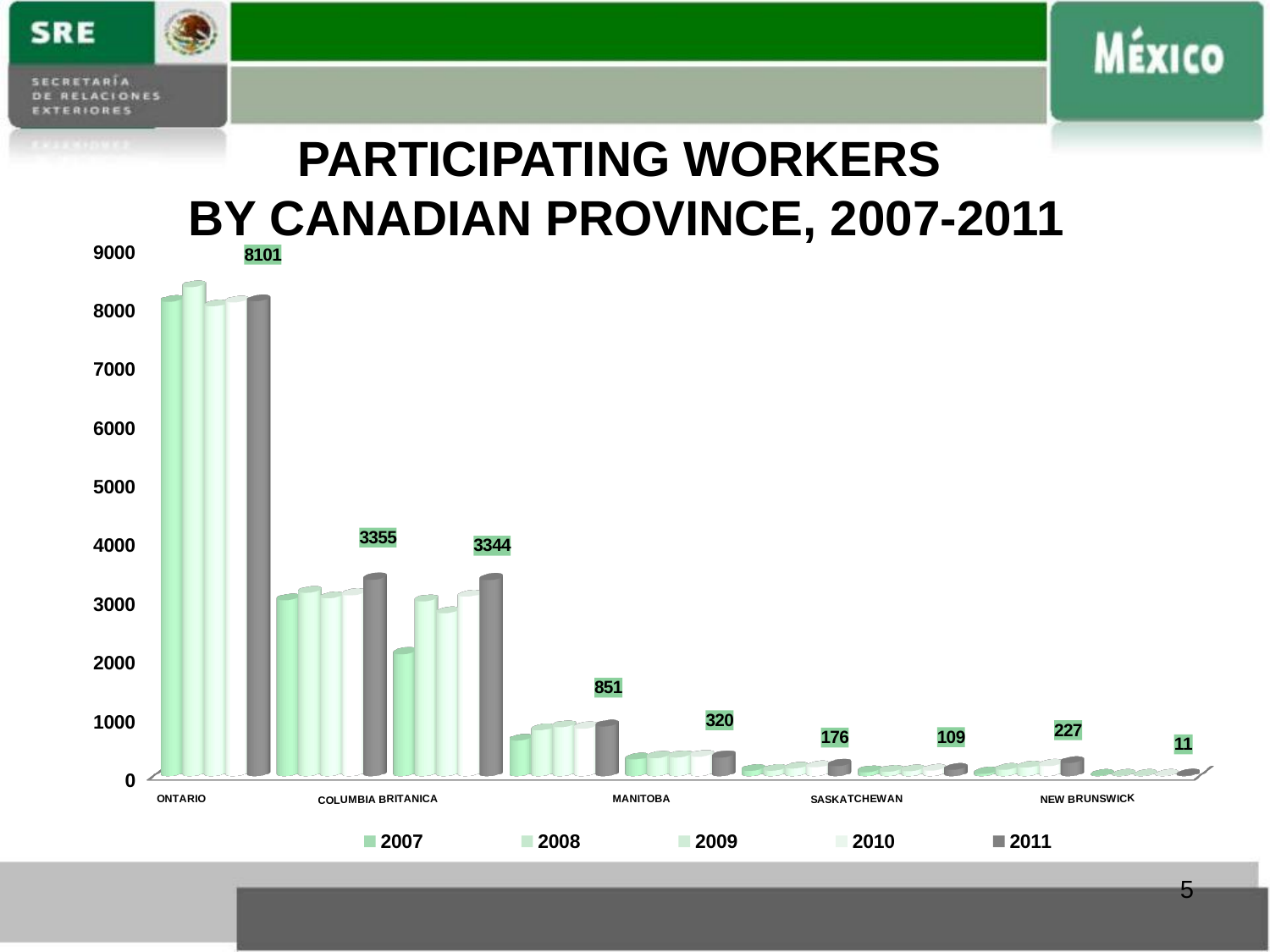
What is the title of the chart? PARTICIPATING WORKERS BY CANADIAN PROVINCE, 2007-2011 What kind of chart is shown on the slide? bar chart What is the largest data label shown on the chart? 8101 Is the 2008 value for ONTARIO greater or less than 8000? greater What is the difference between the data labels 3355 and 3344? 11 Do the values generally rise or fall moving from ONTARIO on the left to NEW BRUNSWICK on the right? fall Which province has the highest number of participating workers? ONTARIO Which years are listed in the legend? 2007, 2008, 2009, 2010, 2011 What is the difference between the ONTARIO label of 8101 and the label of 3355? 4746 What is the smallest data label shown on the chart? 11 How many series does the legend list? 5 What is the labelled 2011 value for ONTARIO? 8101